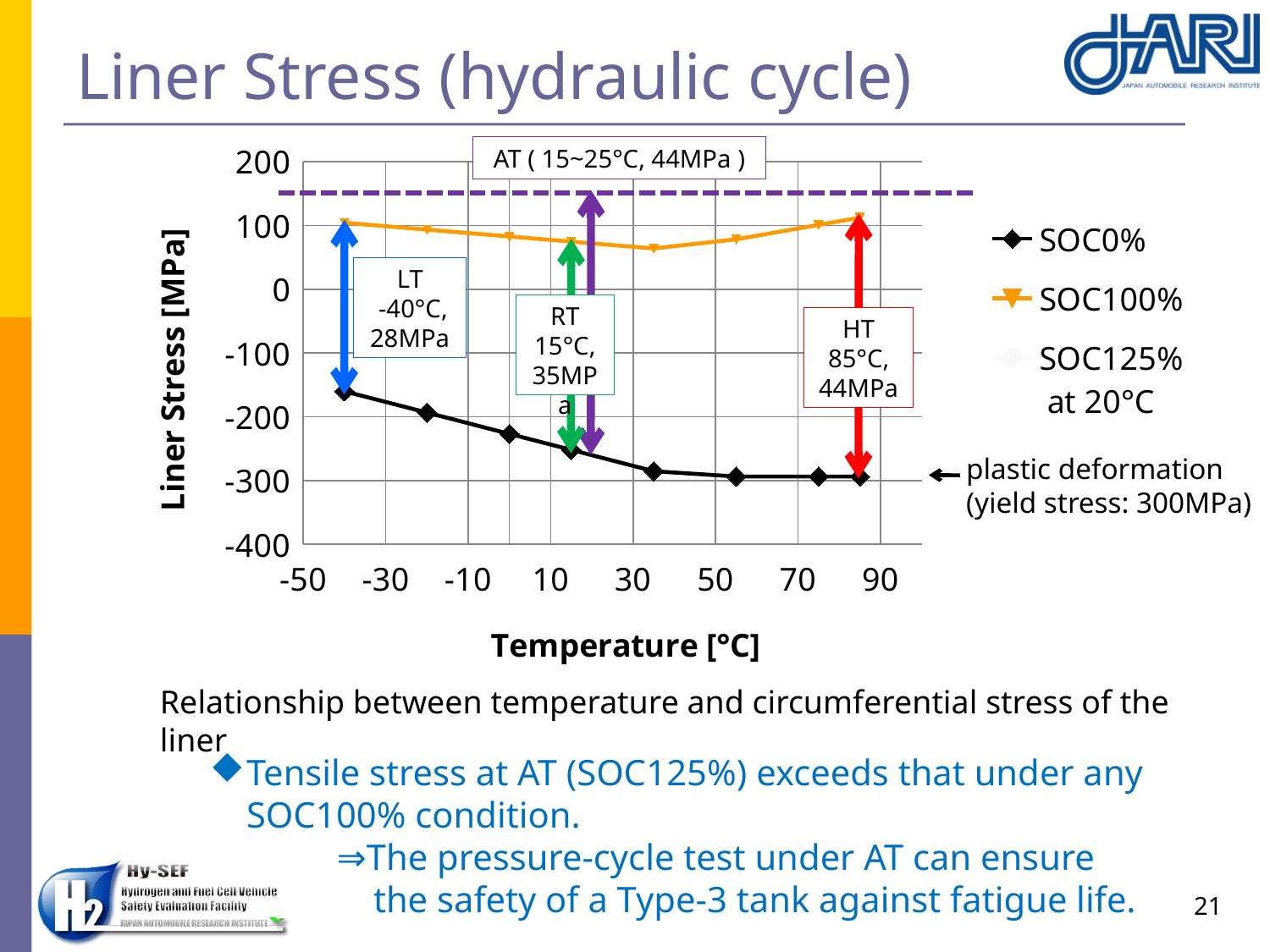
At which temperature does the SOC100% series reach its lowest liner stress? 35°C At which temperature does the SOC0% series reach its highest liner stress? -40°C Is the SOC100% value at 35°C greater or less than 0 MPa? greater What kind of chart is shown on the slide? line chart At 15°C, which series has the larger liner stress, SOC0% or SOC100%? SOC100% Is the SOC0% value at -40°C greater or less than -100 MPa? less Is the SOC0% value at 85°C greater or less than -200 MPa? less How many series does the legend list? 3 What is the label of the vertical axis? Liner Stress [MPa] Does the SOC0% liner stress rise or fall as temperature increases along the x axis? fall How many data points are plotted for the SOC0% series? 8